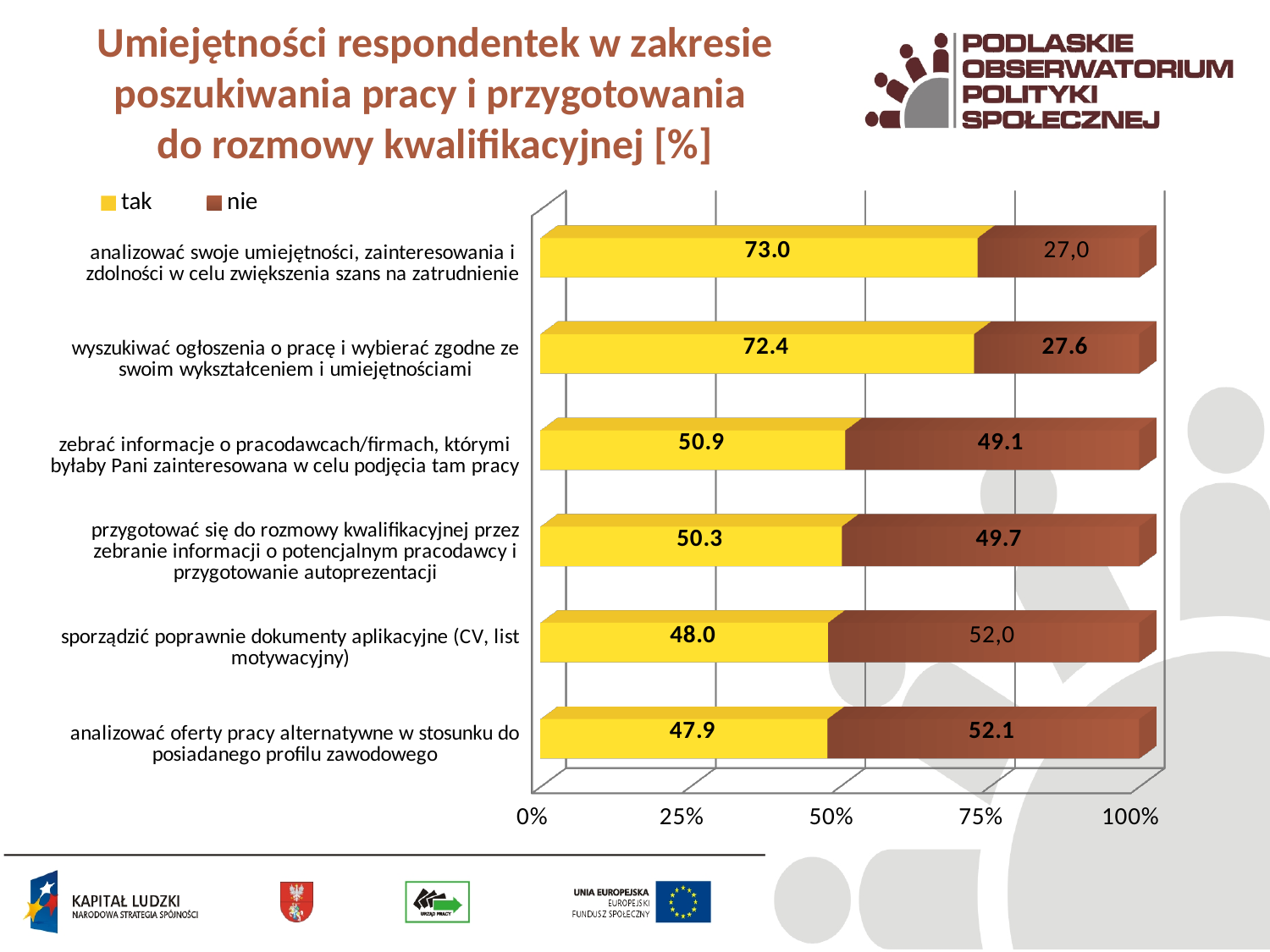
Which colour represents the 'nie' series in the chart? brown Which category has the highest 'tak' value? analizować swoje umiejętności, zainteresowania i zdolności w celu zwiększenia szans na zatrudnienie Which category has the lowest 'tak' value? analizować oferty pracy alternatywne w stosunku do posiadanego profilu zawodowego What is the total of the stacked bar for 'przygotować się do rozmowy kwalifikacyjnej przez zebranie informacji o potencjalnym pracodawcy i przygotowanie autoprezentacji'? 100.0 What is the difference between the 'nie' and 'tak' values for 'analizować oferty pracy alternatywne w stosunku do posiadanego profilu zawodowego'? 4.2 What type of chart is shown on the slide? bar chart Which is larger for 'zebrać informacje o pracodawcach/firmach, którymi byłaby Pani zainteresowana w celu podjęcia tam pracy': the 'tak' value or the 'nie' value? tak What is the 'nie' value for 'wyszukiwać ogłoszenia o pracę i wybierać zgodne ze swoim wykształceniem i umiejętnościami'? 27.6 What is the 'tak' value for 'analizować swoje umiejętności, zainteresowania i zdolności w celu zwiększenia szans na zatrudnienie'? 73.0 How many series does the legend list? 2 How many categories are plotted in the chart? 6 What is the 'tak' value for 'sporządzić poprawnie dokumenty aplikacyjne (CV, list motywacyjny)'? 48.0